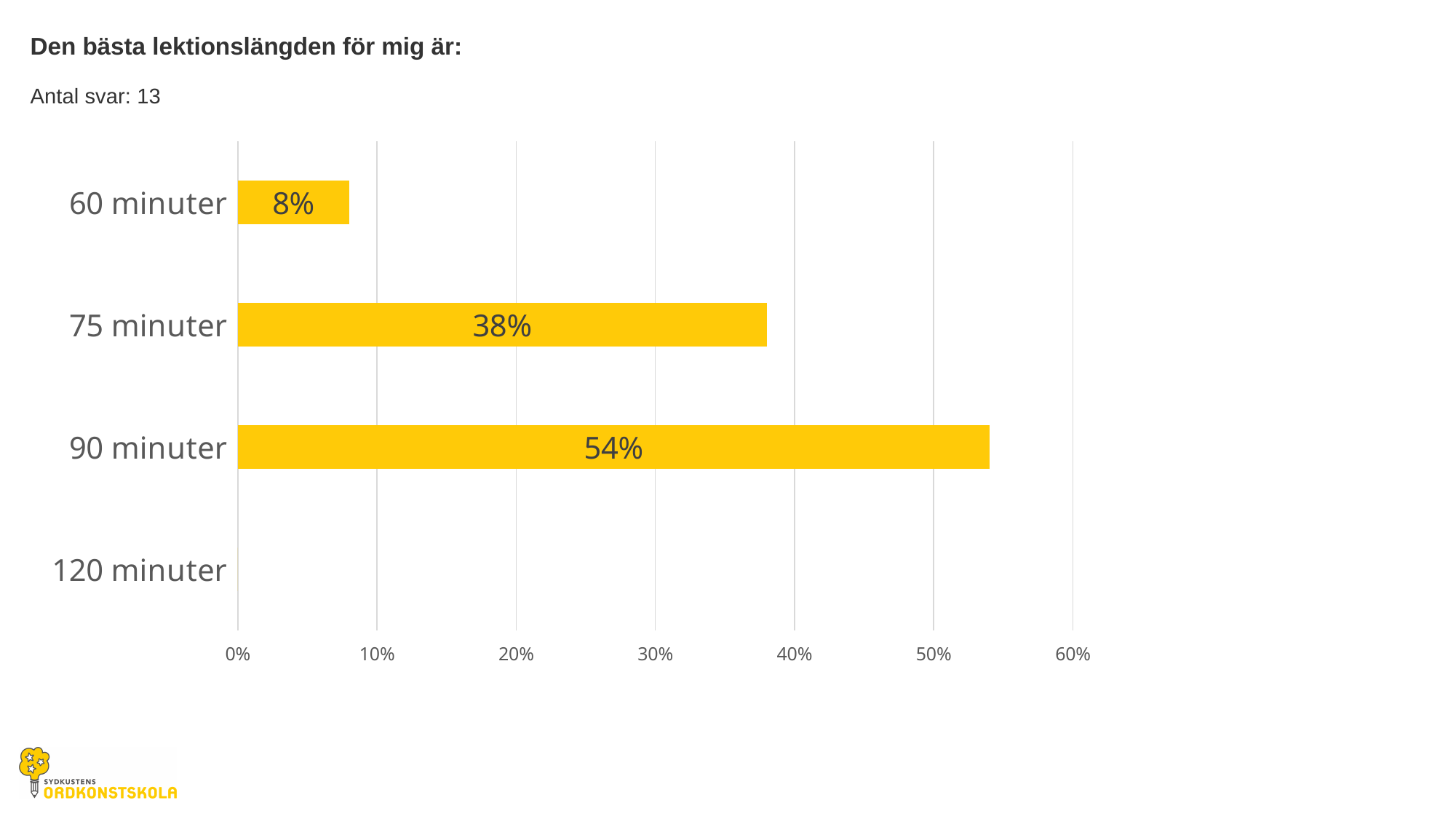
Which category has the highest value? 90 minuter Which is larger, the value for 75 minuter or the value for 60 minuter? 75 minuter What is the value for 75 minuter? 38% What is the difference between the values for 90 minuter and 75 minuter? 16% What is the title of the chart? Den bästa lektionslängden för mig är: Which category has the lowest value among those with a visible bar? 60 minuter How many categories are shown on the chart? 4 Is the value for 90 minuter greater or less than 50%? greater What kind of chart is shown on the slide? bar chart What is the difference between the values for 75 minuter and 60 minuter? 30% What is the value for 60 minuter? 8% What is the value for 90 minuter? 54%